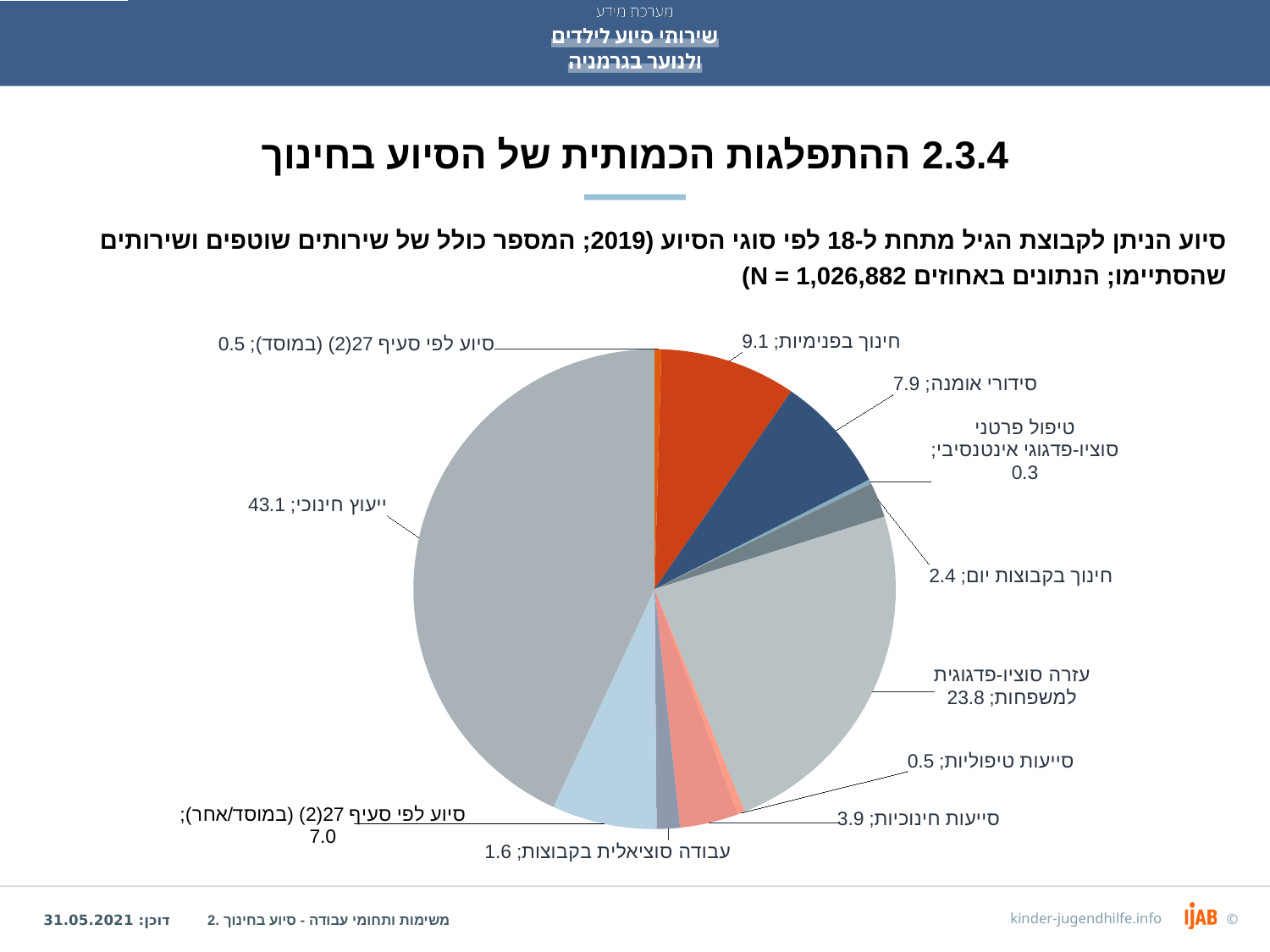
What type of chart is shown on the slide? pie chart What is the value shown for עזרה סוציו-פדגוגית למשפחות? 23.8 What is the title of the slide's chart section? 2.3.4 ההתפלגות הכמותית של הסיוע בחינוך What is the value shown for סידורי אומנה? 7.9 How many slices does the pie chart have? 11 What is the value shown for סייעות חינוכיות? 3.9 What is the value shown for חינוך בפנימיות? 9.1 What is the value shown for ייעוץ חינוכי? 43.1 Which is larger, the value for חינוך בפנימיות or the value for סידורי אומנה? חינוך בפנימיות What is the difference between the values for ייעוץ חינוכי and עזרה סוציו-פדגוגית למשפחות? 19.3 Which category has the smallest slice of the pie? טיפול פרטני סוציו-פדגוגי אינטנסיבי Which category has the largest slice of the pie? ייעוץ חינוכי